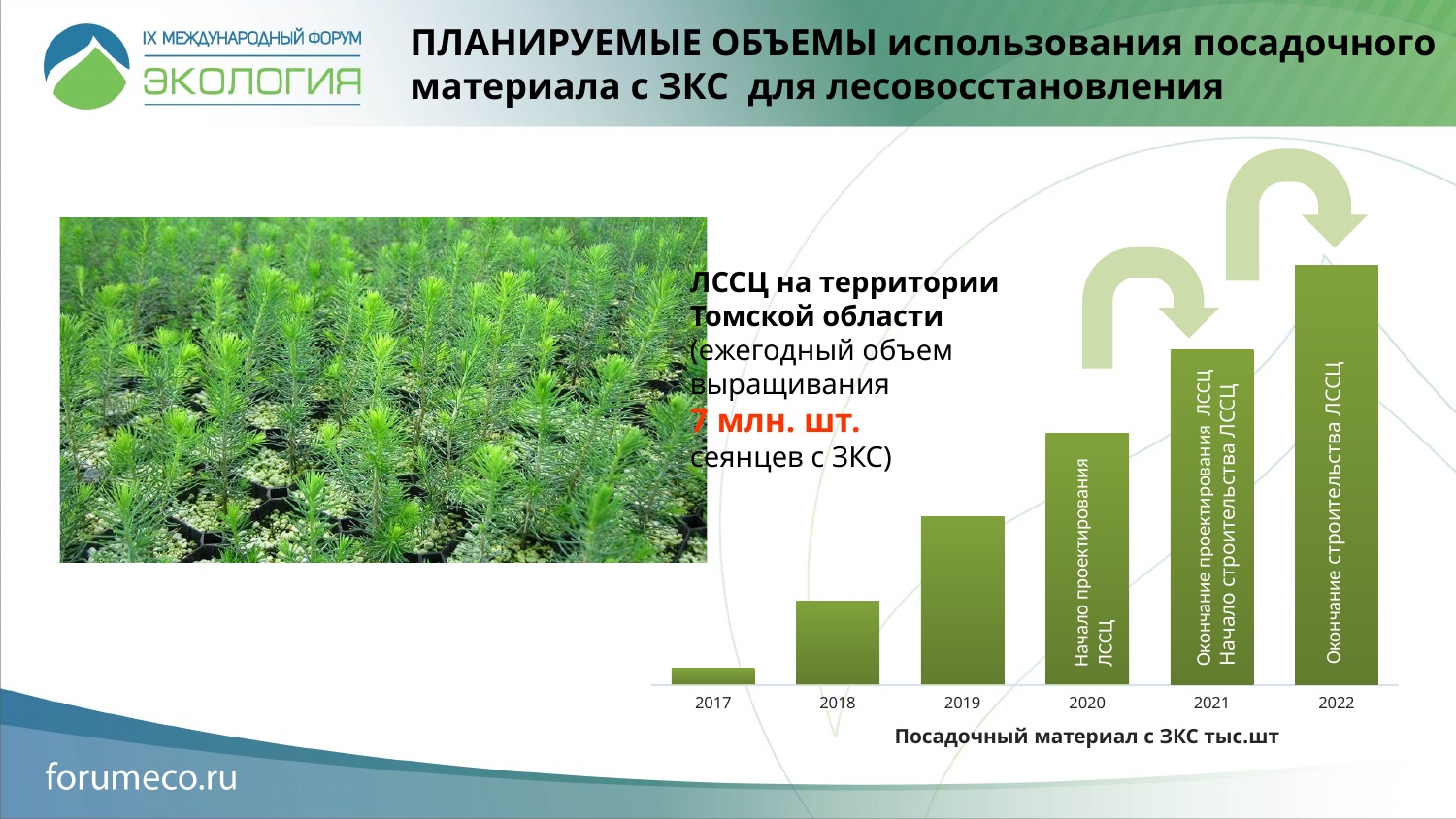
Which year has the tallest bar in the chart? 2022 What kind of chart is shown on the slide? bar chart How many years are shown on the x axis of the chart? 6 Which year has the shortest bar in the chart? 2017 What is the axis title written below the chart? Посадочный материал с ЗКС тыс.шт Which bar is taller, 2018 or 2017? 2018 Which year's bar is labelled "Окончание строительства ЛССЦ"? 2022 What is the first year shown on the x axis of the chart? 2017 What is the last year shown on the x axis of the chart? 2022 Do the bar values rise or fall from 2017 to 2022? rise Which bar is taller, 2019 or 2021? 2021